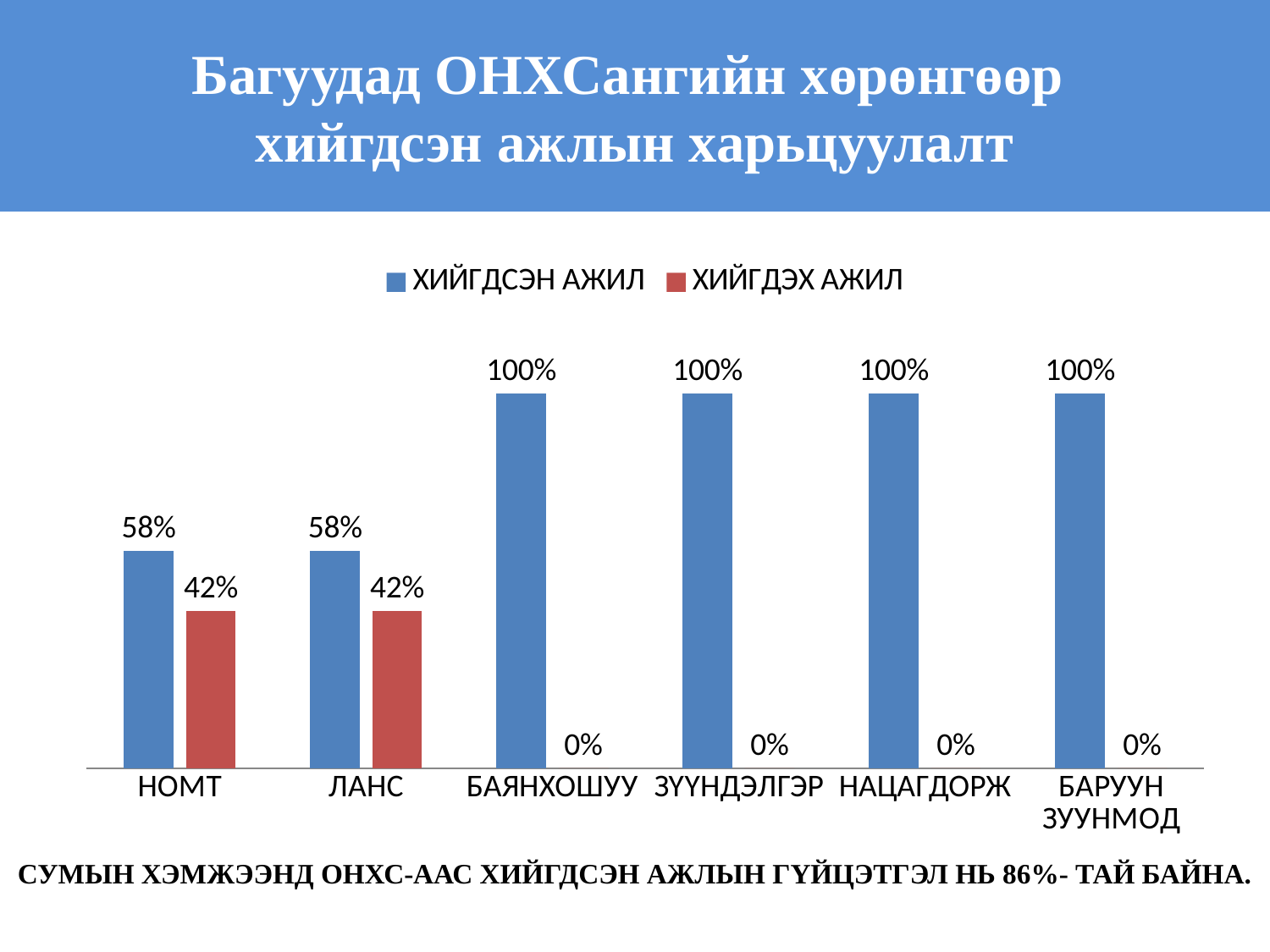
What is the difference between the ХИЙГДСЭН АЖИЛ and ХИЙГДЭХ АЖИЛ values for НОМТ? 16% What is the ХИЙГДСЭН АЖИЛ value for НОМТ? 58% How many series does the legend list? 2 How many categories are shown on the x axis? 6 Is the ХИЙГДСЭН АЖИЛ value for ЛАНС greater or less than the ХИЙГДСЭН АЖИЛ value for НАЦАГДОРЖ? less What is the ХИЙГДЭХ АЖИЛ value for НАЦАГДОРЖ? 0% What is the difference between the ХИЙГДСЭН АЖИЛ values for ЗҮҮНДЭЛГЭР and ЛАНС? 42% What kind of chart is shown on the slide? Bar chart Which colour represents the ХИЙГДЭХ АЖИЛ series? Red What is the ХИЙГДЭХ АЖИЛ value for ЛАНС? 42% Which category has the highest ХИЙГДЭХ АЖИЛ value, НОМТ or БАРУУН ЗУУНМОД? НОМТ What is the ХИЙГДСЭН АЖИЛ value for БАЯНХОШУУ? 100%